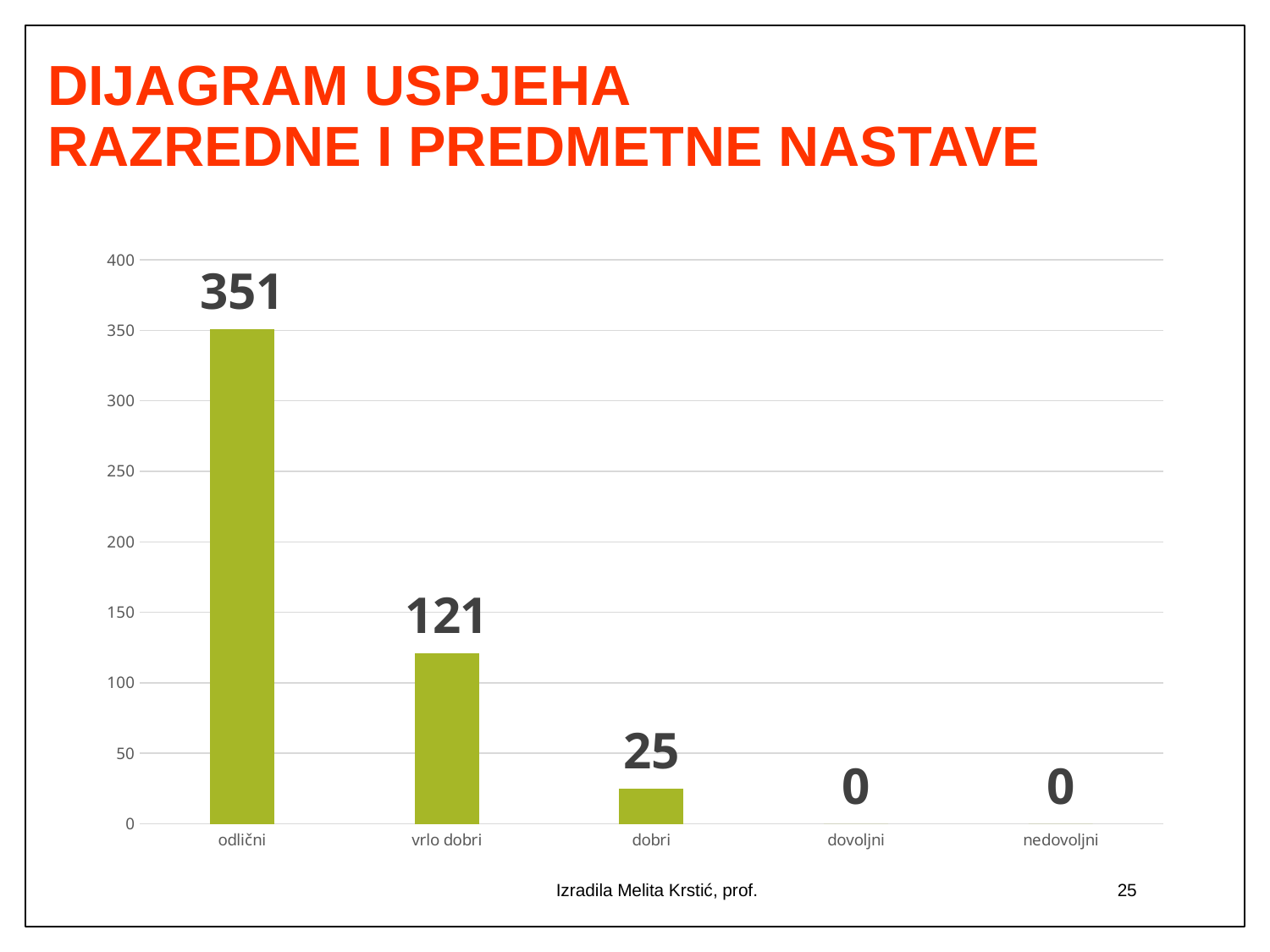
What kind of chart is shown on the slide? bar chart What is the difference between the values for odlični and vrlo dobri? 230 How many categories are shown on the x axis? 5 Is the value for odlični greater or less than 300? greater Which category has the highest value? odlični Which is larger, the value for vrlo dobri or the value for dobri? vrlo dobri Do the values rise or fall from left to right along the x axis? fall What is the value for dovoljni? 0 What is the value for vrlo dobri? 121 What is the value for dobri? 25 What is the difference between the values for vrlo dobri and dobri? 96 What is the value for odlični? 351